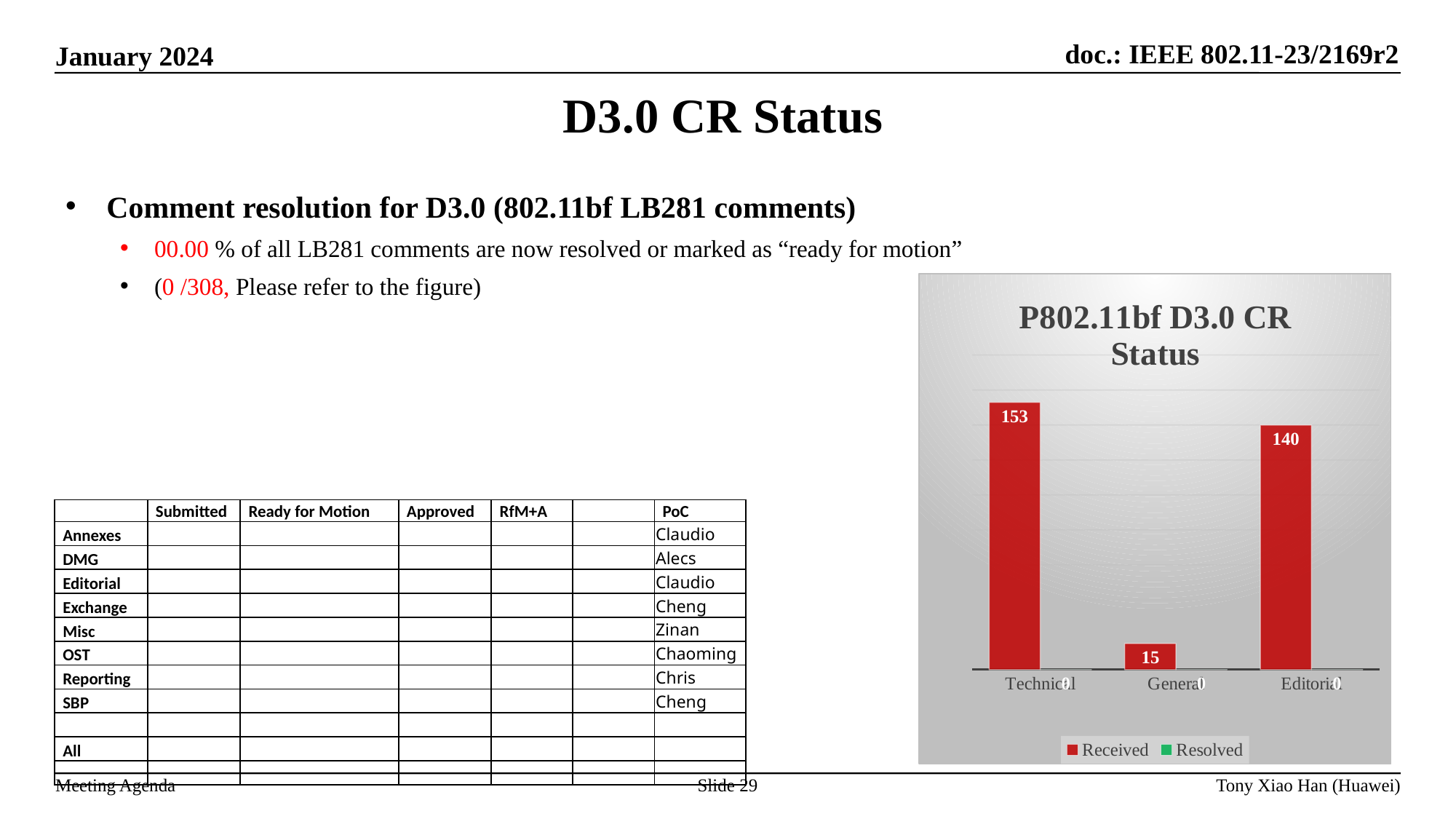
What is the Received value for General? 15 What is the Received value for Editorial? 140 What type of chart is shown on the slide? bar chart What is the title of the chart? P802.11bf D3.0 CR Status What is the difference between the Received values for Technical and Editorial? 13 Which is larger, the Received value for Editorial or for General? Editorial What is the Received value for Technical? 153 How many series does the chart legend list? 2 What are the two series named in the chart legend? Received and Resolved Which category has the lowest Received value? General Which category has the highest Received value? Technical How many categories are shown on the x axis of the chart? 3